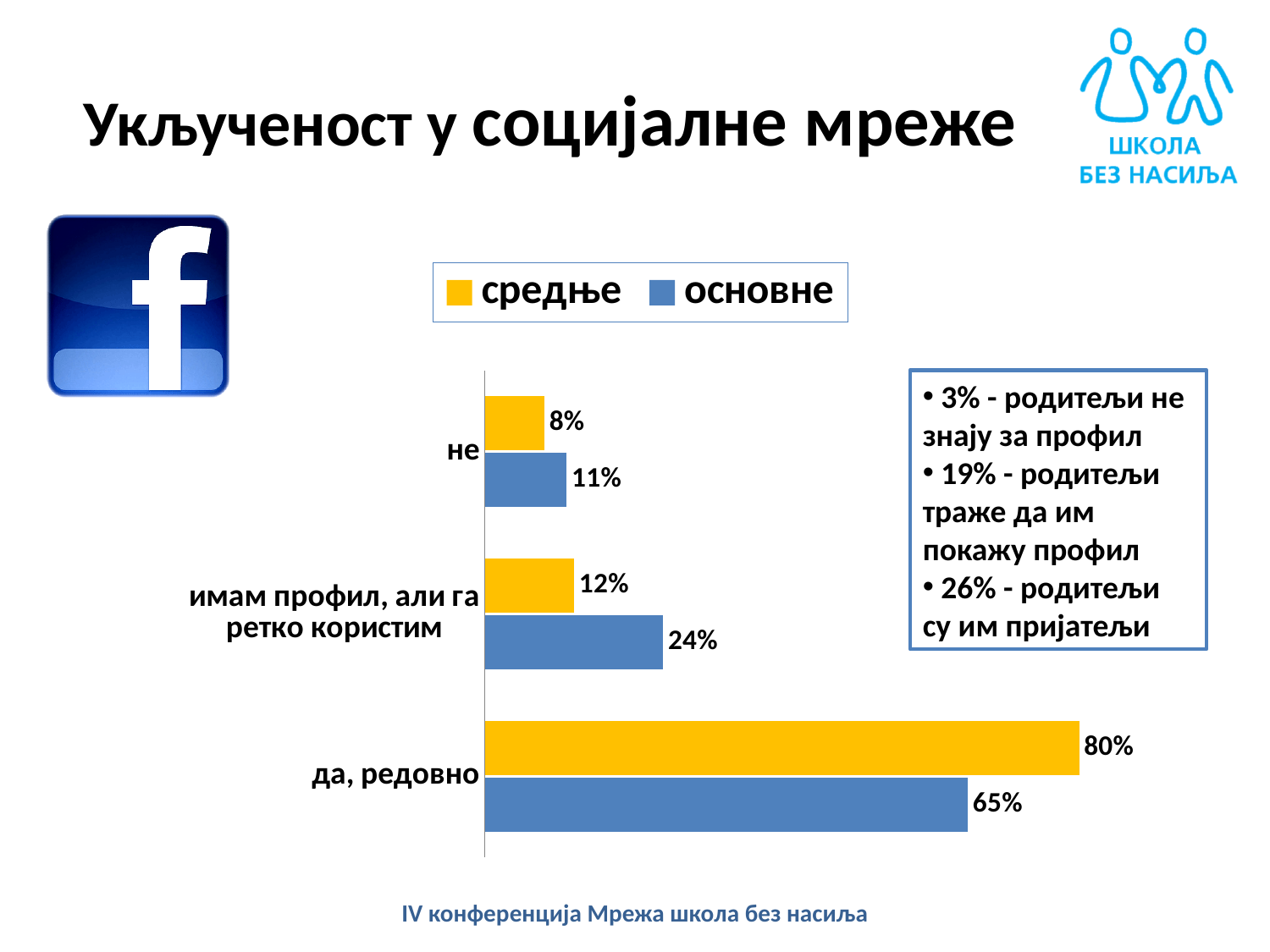
What is the value for "средње" in the "да, редовно" category? 80% How many categories are shown on the chart? 3 What is the value for "основне" in the "имам профил, али га ретко користим" category? 24% What is the value for "основне" in the "да, редовно" category? 65% What kind of chart is shown on the slide? bar chart What is the difference between "основне" and "средње" in the "имам профил, али га ретко користим" category? 12% How many series does the legend list? 2 Which category has the highest value for "основне"? да, редовно Which category has the lowest value for "средње"? не In the "не" category, which series has the larger value, "средње" or "основне"? основне What is the value for "средње" in the "не" category? 8% What is the difference between "средње" and "основне" in the "да, редовно" category? 15%